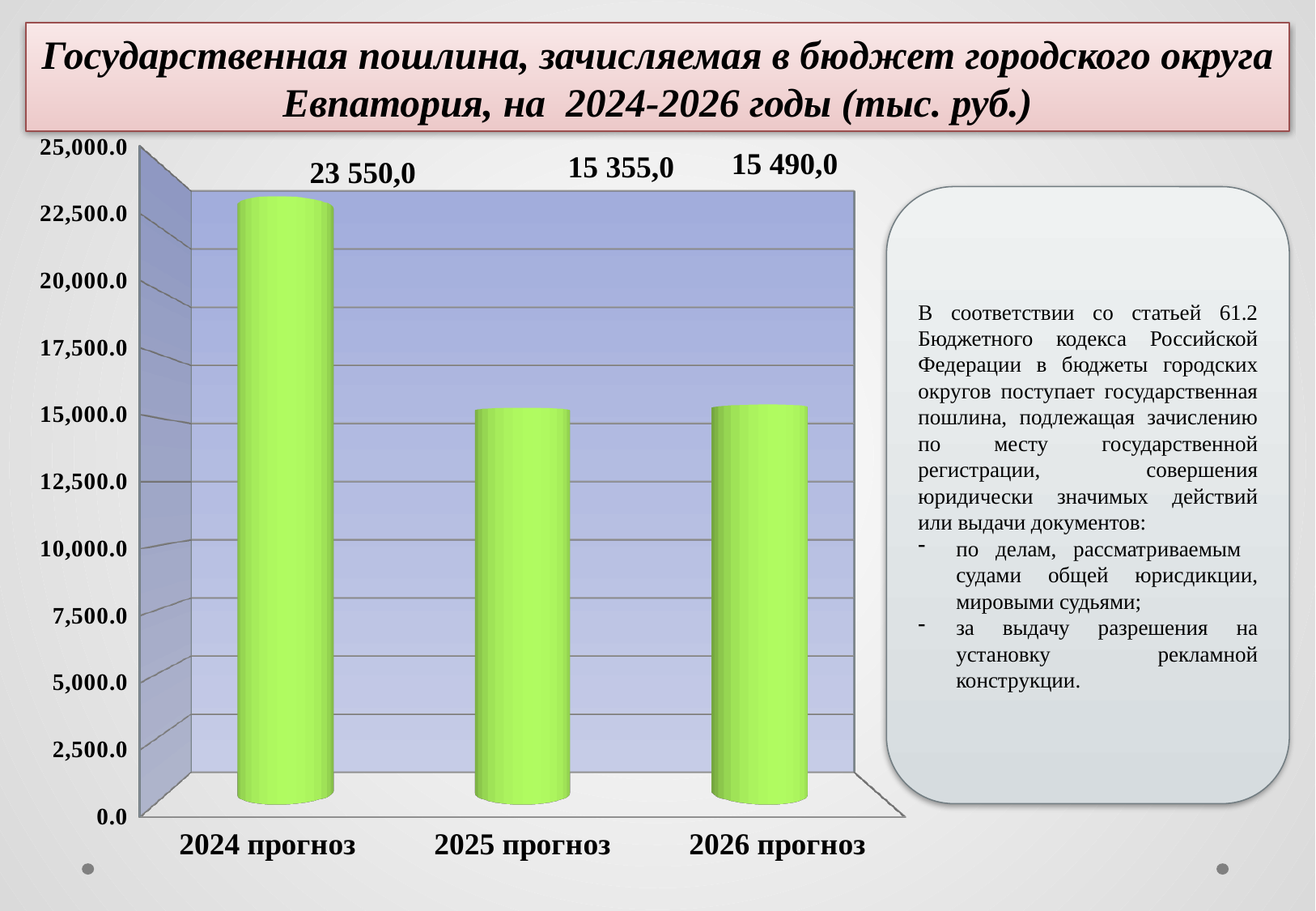
What is the value for 2024 прогноз? 23 550,0 Which year has the lowest value according to the data labels? 2025 прогноз What is the difference between the values for 2026 прогноз and 2025 прогноз? 135,0 How many bars are shown in the chart? 3 What unit of measurement is given in the chart title? тыс. руб. What is the value for 2025 прогноз? 15 355,0 Is the value for 2024 прогноз greater or less than 20,000.0? greater Which year has the highest value? 2024 прогноз What is the value for 2026 прогноз? 15 490,0 According to the data labels, which is larger: the value for 2025 прогноз or 2026 прогноз? 2026 прогноз What kind of chart is shown on the slide? bar chart What is the difference between the values for 2024 прогноз and 2025 прогноз? 8 195,0